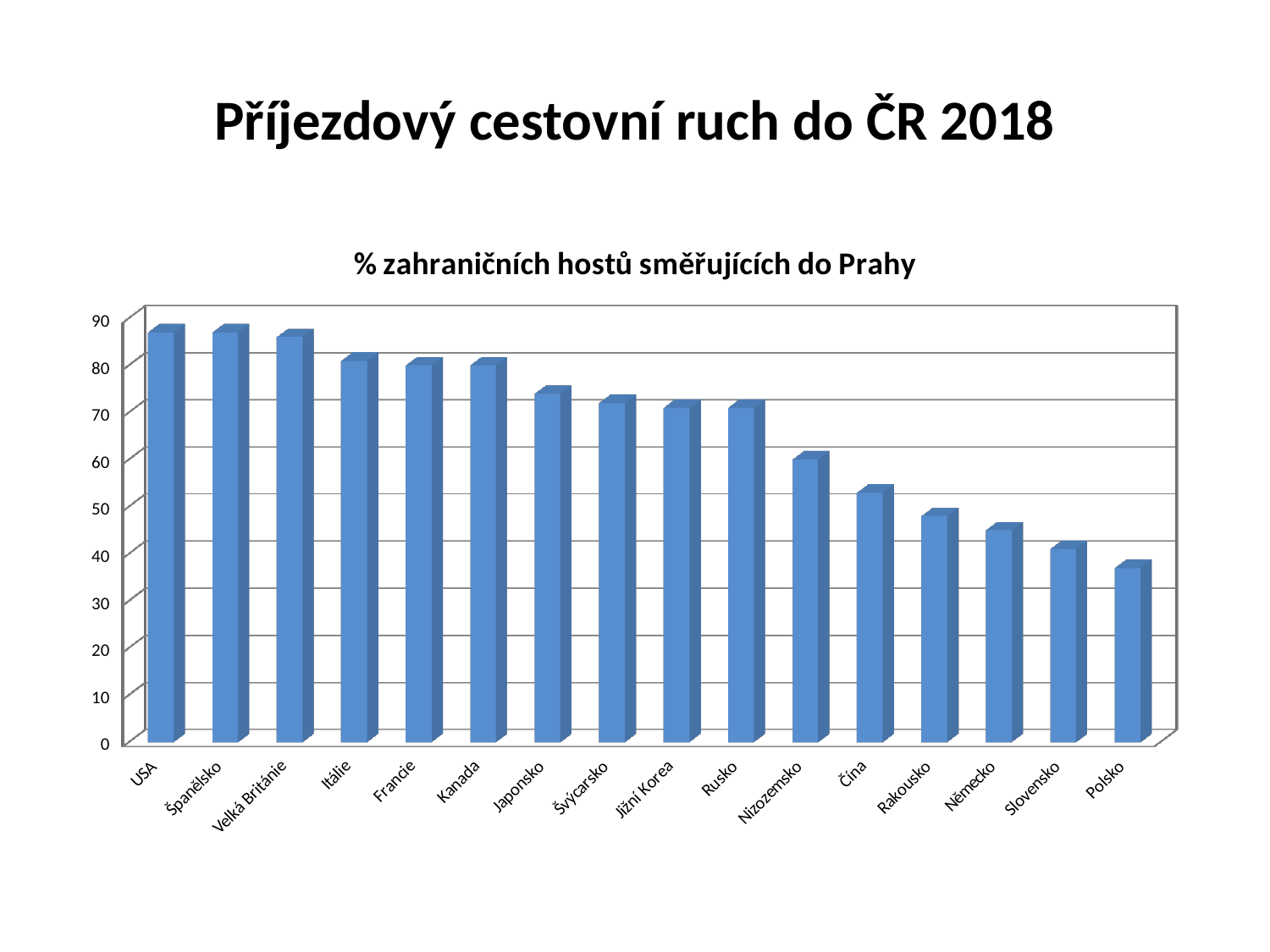
Do the values rise or fall moving from left to right along the x axis? fall What kind of chart is shown on the slide? bar chart How many countries are shown on the x axis of the chart? 16 Is the value for Polsko greater or less than 40? less Which has the larger value, Rakousko or Velká Británie? Velká Británie Is the value for Čína greater or less than 50? greater Is the value for Německo greater or less than 50? less What is the title of the chart? % zahraničních hostů směřujících do Prahy Which country has the lowest value in the chart? Polsko Which has the larger value, Itálie or Nizozemsko? Itálie